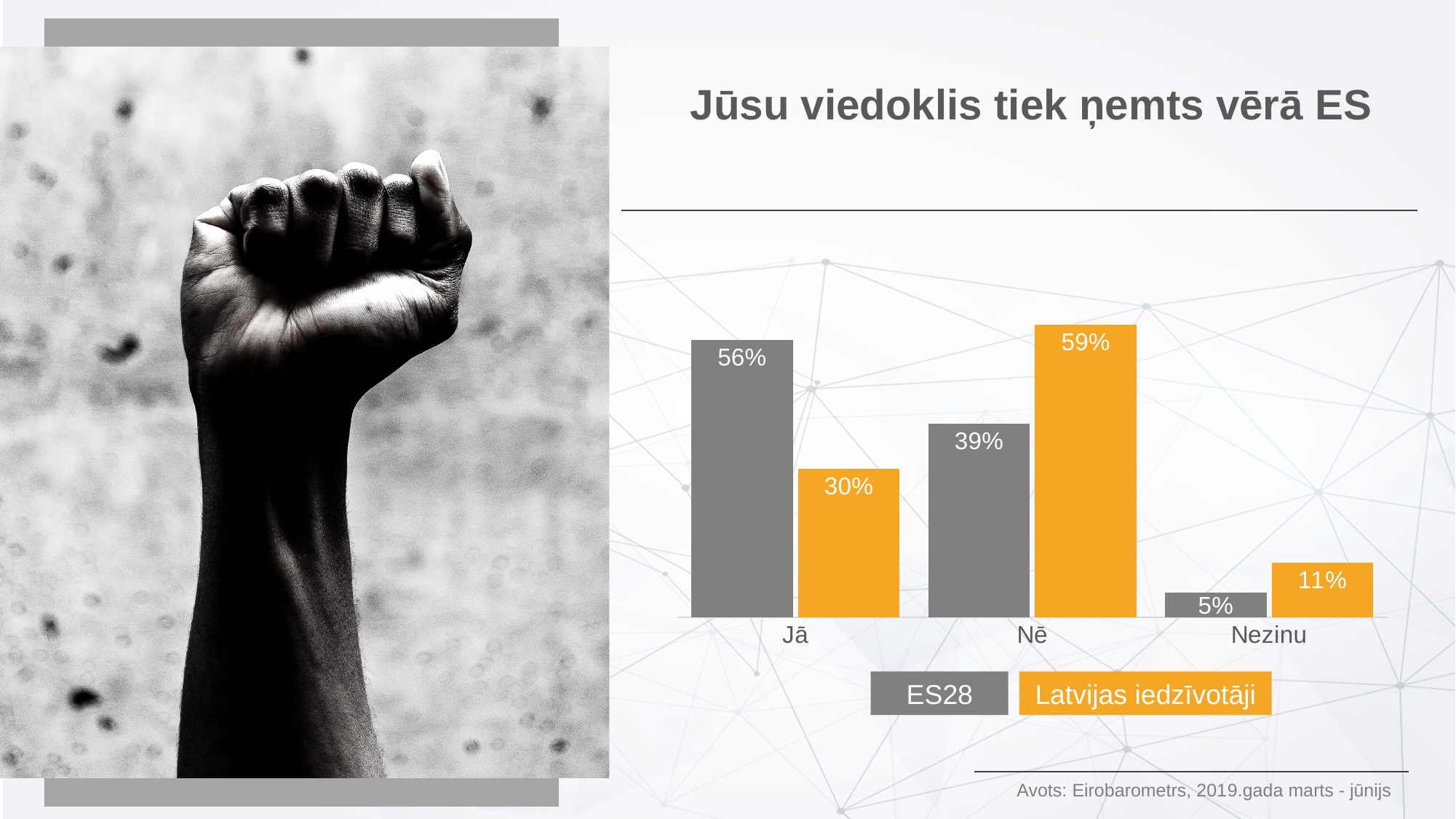
What is the Latvijas iedzīvotāji value for Jā? 30% What kind of chart is shown on the slide? Bar chart How many categories are shown on the x axis? 3 Which category has the lowest ES28 value? Nezinu What is the difference between the ES28 and Latvijas iedzīvotāji values for Jā? 26% What is the ES28 value for Jā? 56% What is the Latvijas iedzīvotāji value for Nē? 59% What is the ES28 value for Nezinu? 5% What is the title of the chart? Jūsu viedoklis tiek ņemts vērā ES For Nē, which series has the larger value, ES28 or Latvijas iedzīvotāji? Latvijas iedzīvotāji How many series does the legend list? 2 Which category has the highest Latvijas iedzīvotāji value? Nē